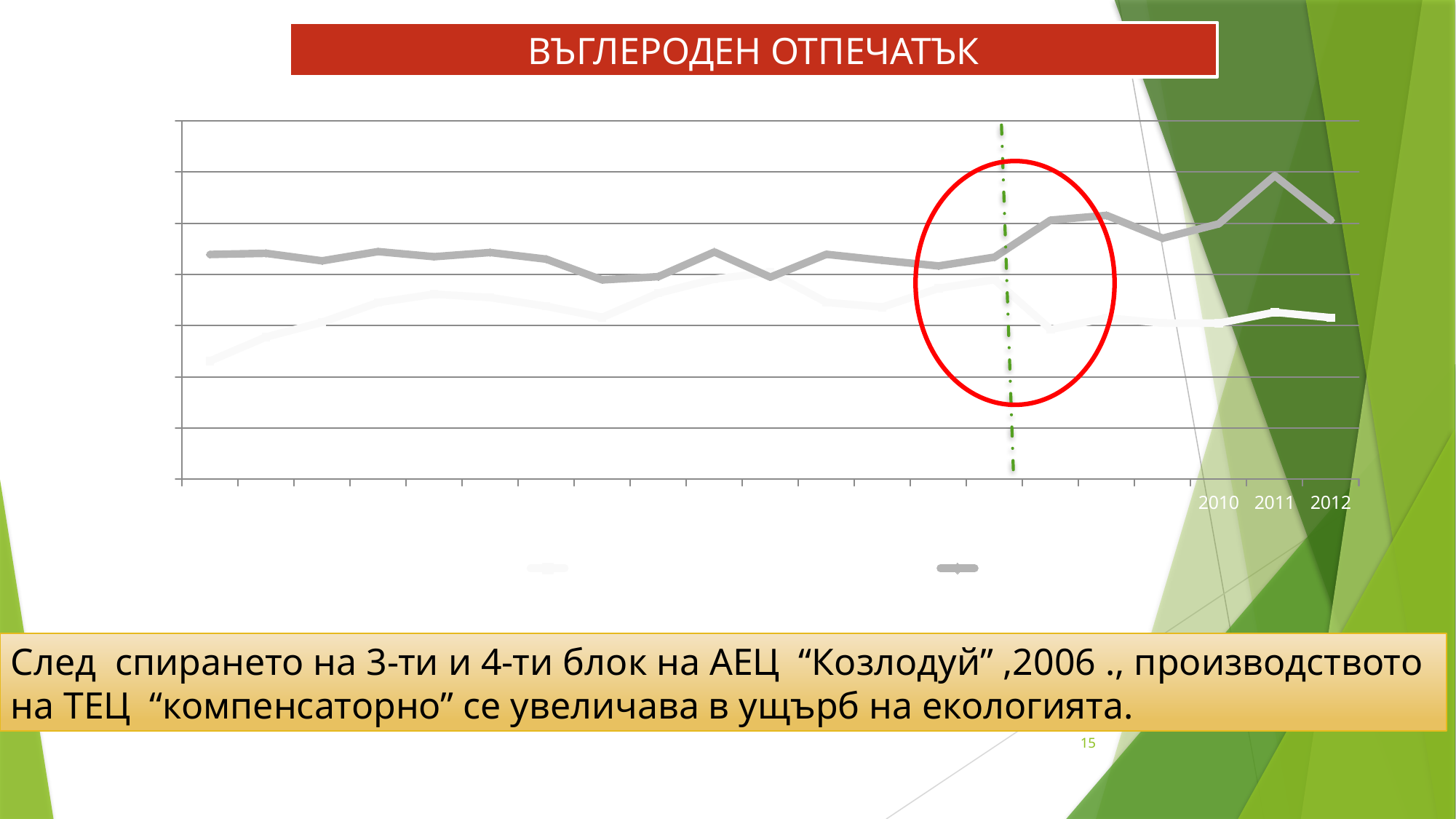
Does the gray line rise or fall from 2011 to 2012? falls What kind of chart is shown on the slide? line chart In which labelled year does the gray (darker) line reach its highest point? 2011 Does the gray line rise or fall from 2010 to 2011? rises Which three years are labelled on the x axis? 2010, 2011, 2012 In 2012, which line is higher, the gray line or the white line? the gray line How many series does the chart's legend list? 2 What is the title shown above the chart? ВЪГЛЕРОДЕН ОТПЕЧАТЪК